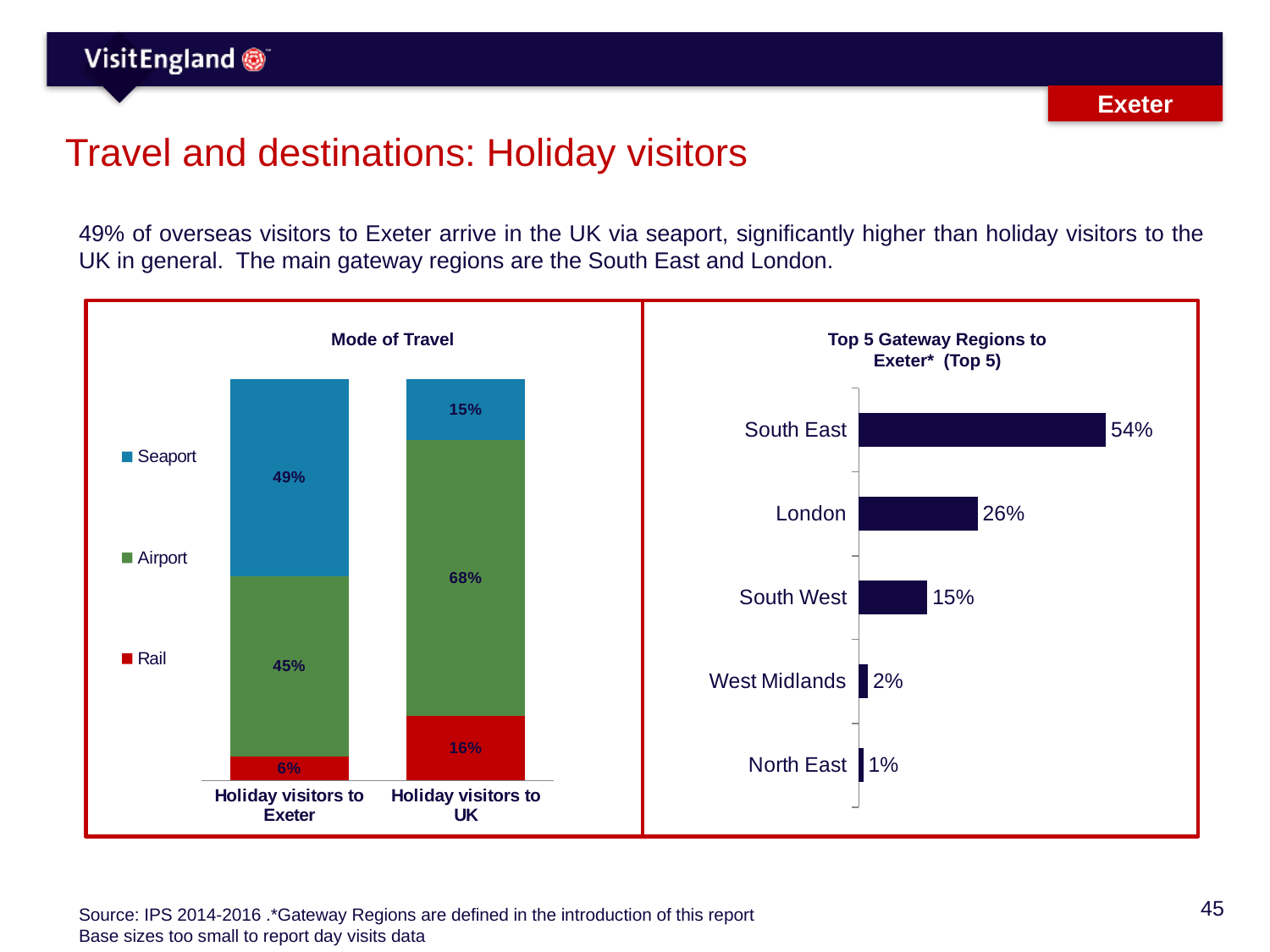
In the Mode of Travel chart, what is the rail share for holiday visitors to Exeter? 6% In the Top 5 Gateway Regions to Exeter chart, which region has the lowest value? North East In the Mode of Travel chart, what percentage of holiday visitors to Exeter arrive by seaport? 49% In the Top 5 Gateway Regions to Exeter chart, what is the value for London? 26% What kind of chart is the Top 5 Gateway Regions to Exeter chart? Bar chart In the Top 5 Gateway Regions to Exeter chart, what is the difference between South East and South West? 39% In the Mode of Travel chart, what is the total of the stacked bar for holiday visitors to Exeter? 100% In the Top 5 Gateway Regions to Exeter chart, which region has the highest value? South East In the Mode of Travel chart, which is larger: the seaport share for holiday visitors to Exeter or for holiday visitors to the UK? Holiday visitors to Exeter In the Mode of Travel chart, what percentage of holiday visitors to the UK arrive by airport? 68% In the Mode of Travel chart, what is the difference between the rail share for holiday visitors to the UK and for holiday visitors to Exeter? 10% In the Mode of Travel chart, how many series does the legend list? 3